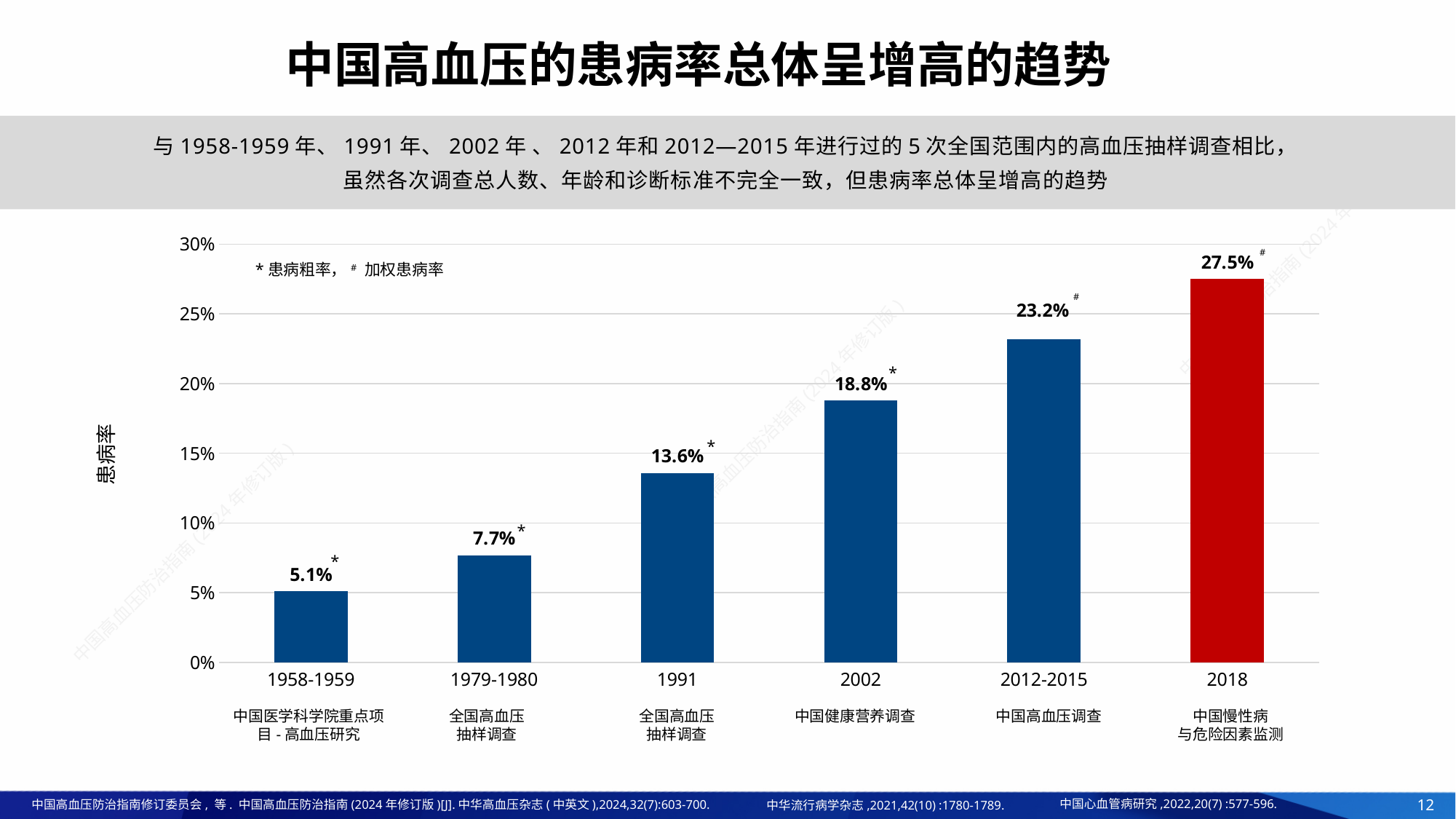
What is the prevalence value shown for 1958-1959? 5.1% How many survey periods are shown on the x axis? 6 What is the difference between the prevalence in 2002 and in 1979-1980? 11.1% What is the prevalence value shown for 2012-2015? 23.2% What is the prevalence value shown for 1991? 13.6% What is the difference between the prevalence in 2018 and in 2012-2015? 4.3% Which is larger, the prevalence for 1991 or for 2002? 2002 What kind of chart is shown on the slide? Bar chart Which period has the highest prevalence in the chart? 2018 Do the prevalence values rise or fall from 1958-1959 to 2018? Rise Is the value for 2018 greater or less than 25%? greater Which period has the lowest prevalence in the chart? 1958-1959